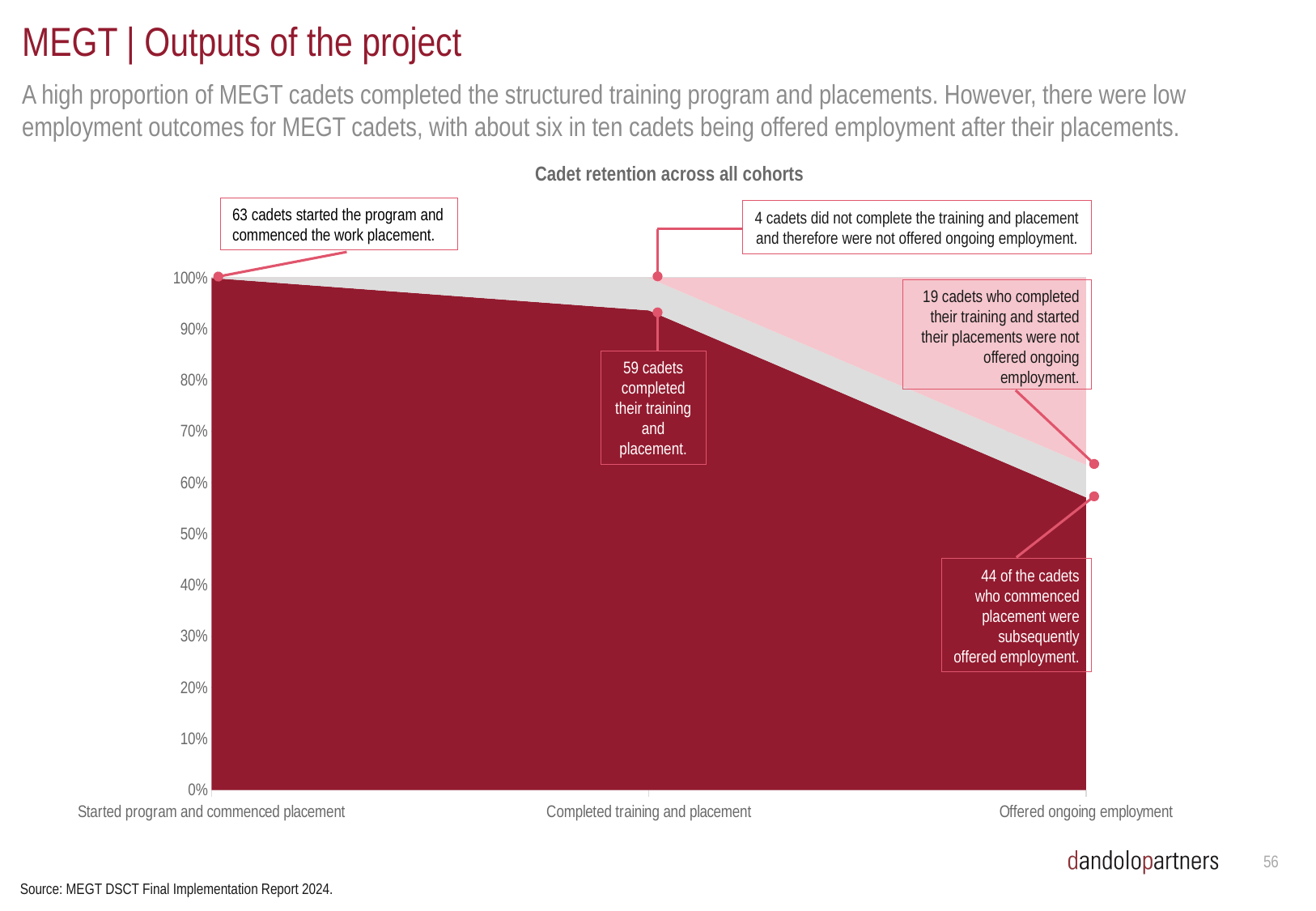
Is the retention value at 'Completed training and placement' greater or less than 90%? greater According to the chart annotations, how many cadets did not complete the training and placement? 4 According to the chart annotations, how many cadets completed their training and placement? 59 Do the retention values rise or fall across the stages from left to right? Fall Is the retention value at 'Offered ongoing employment' greater or less than 60%? less What is the title of the chart? Cadet retention across all cohorts What is the difference between the number of cadets who completed their training and placement and the number offered employment? 15 According to the chart annotations, how many cadets who completed their training and started their placements were not offered ongoing employment? 19 What kind of chart is shown on the slide? Area chart How many categories are shown on the x axis of the chart? 3 According to the chart annotations, how many cadets started the program and commenced the work placement? 63 According to the chart annotations, how many cadets who commenced placement were subsequently offered employment? 44